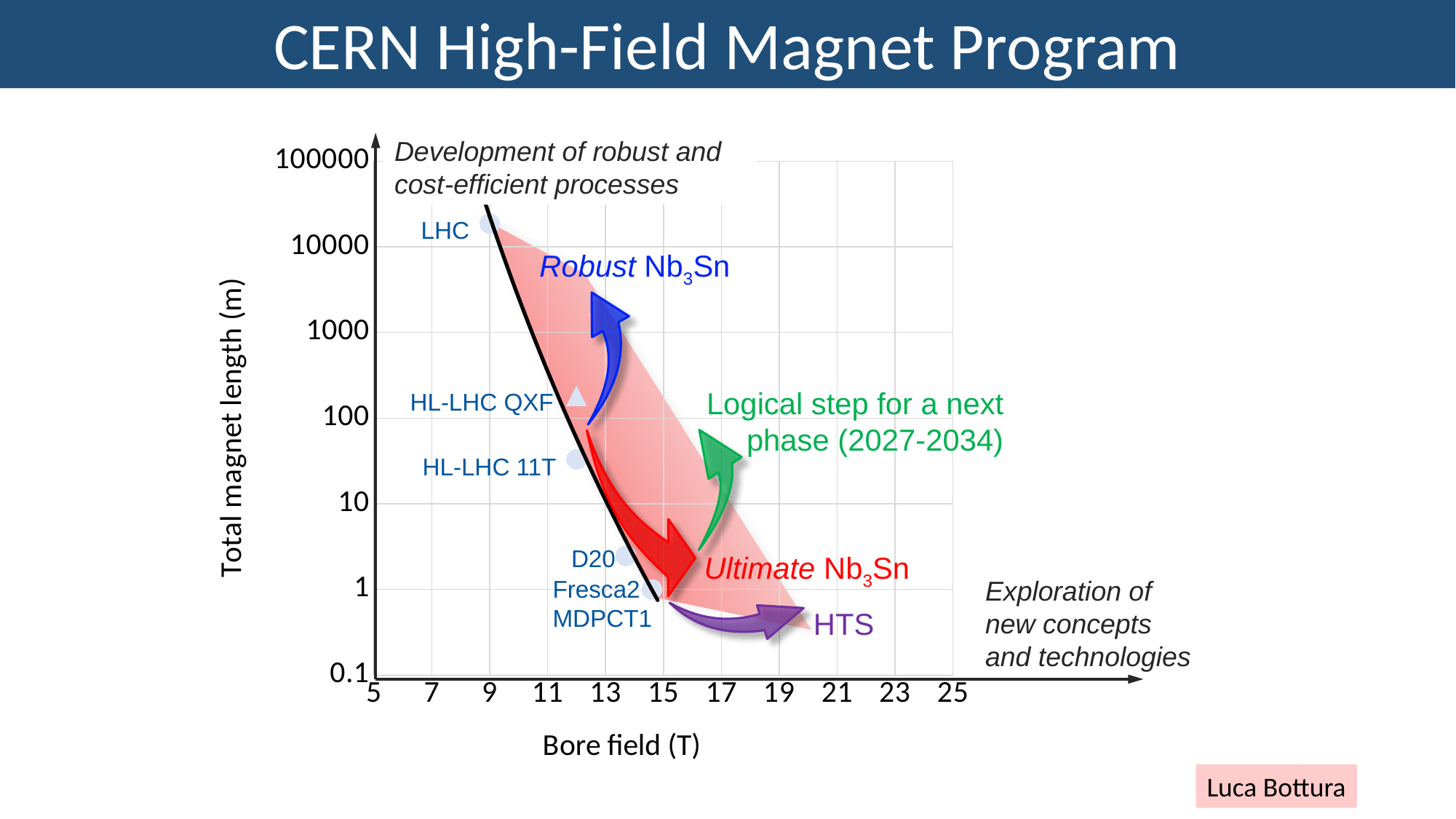
What is the label of the x axis of the chart? Bore field (T) Is the bore field for LHC greater or less than 11? less Is the total magnet length for LHC greater or less than 10000? greater What kind of chart is shown on the slide? scatter chart Is the total magnet length for HL-LHC 11T greater or less than 100? less What is the label of the y axis of the chart? Total magnet length (m) Which has the larger total magnet length, HL-LHC QXF or HL-LHC 11T? HL-LHC QXF How many labeled magnets are plotted on the chart? 6 Which labeled magnet has the greatest total magnet length? LHC Which labeled magnet has the lowest bore field? LHC